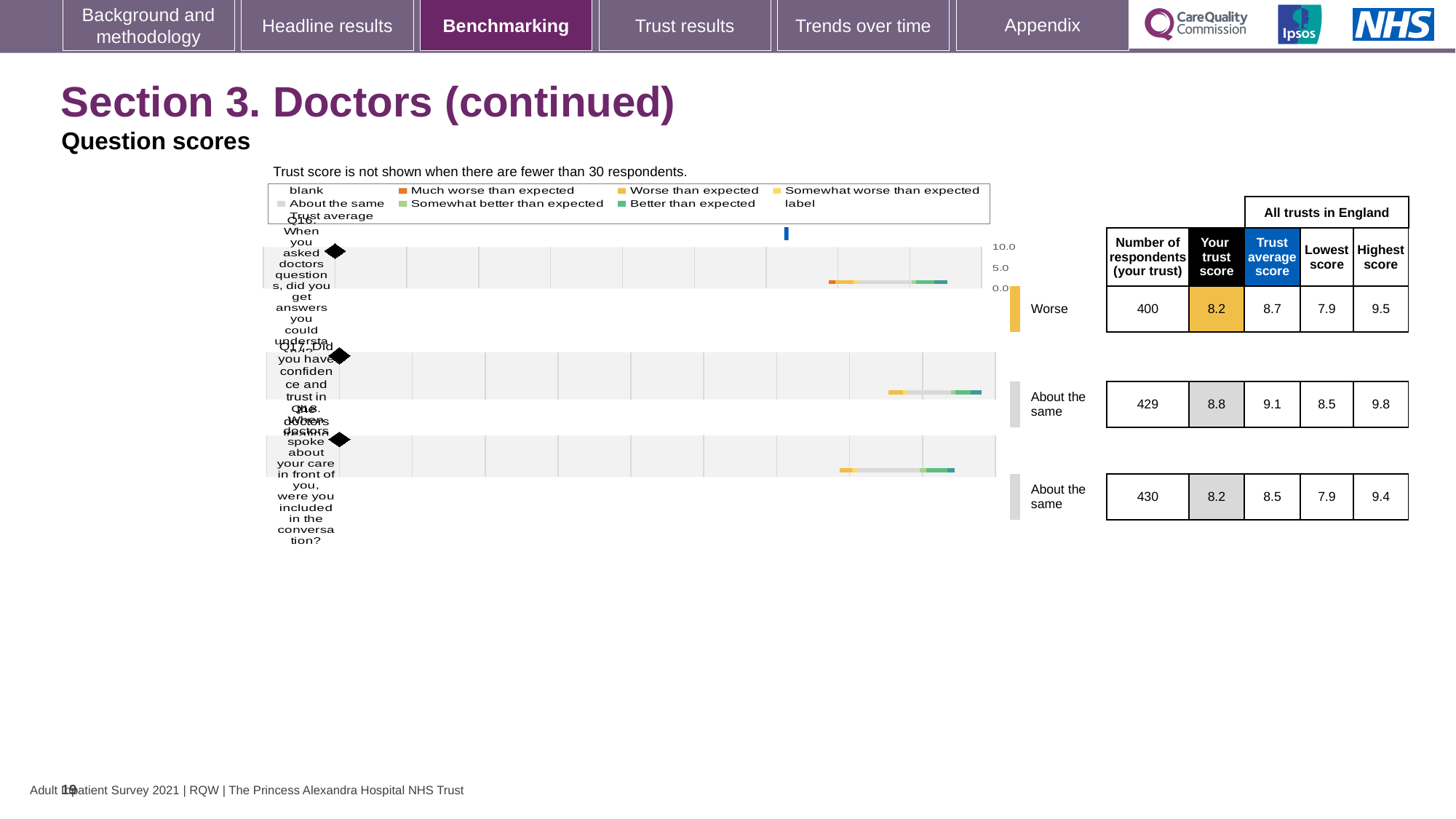
What kind of chart is used to show the question scores? bar chart What is the trust score for Q17 (did you have confidence and trust in the doctors)? 8.8 Which question has the fewest respondents? Q16 What is the highest score across all trusts in England for Q17? 9.8 What is the trust score for Q16 (when you asked doctors questions, did you get answers you could understand)? 8.2 What is the difference between the trust average score and this trust's score for Q16? 0.5 How many questions are plotted on the chart? 3 Is the trust score for Q17 higher or lower than the trust average score for Q17? lower Which question has the highest trust score for this trust? Q17 How many respondents answered Q18 (were you included in the conversation when doctors spoke about your care)? 430 What is the trust average score for all trusts in England for Q16? 8.7 What benchmark category is shown for Q16? Worse